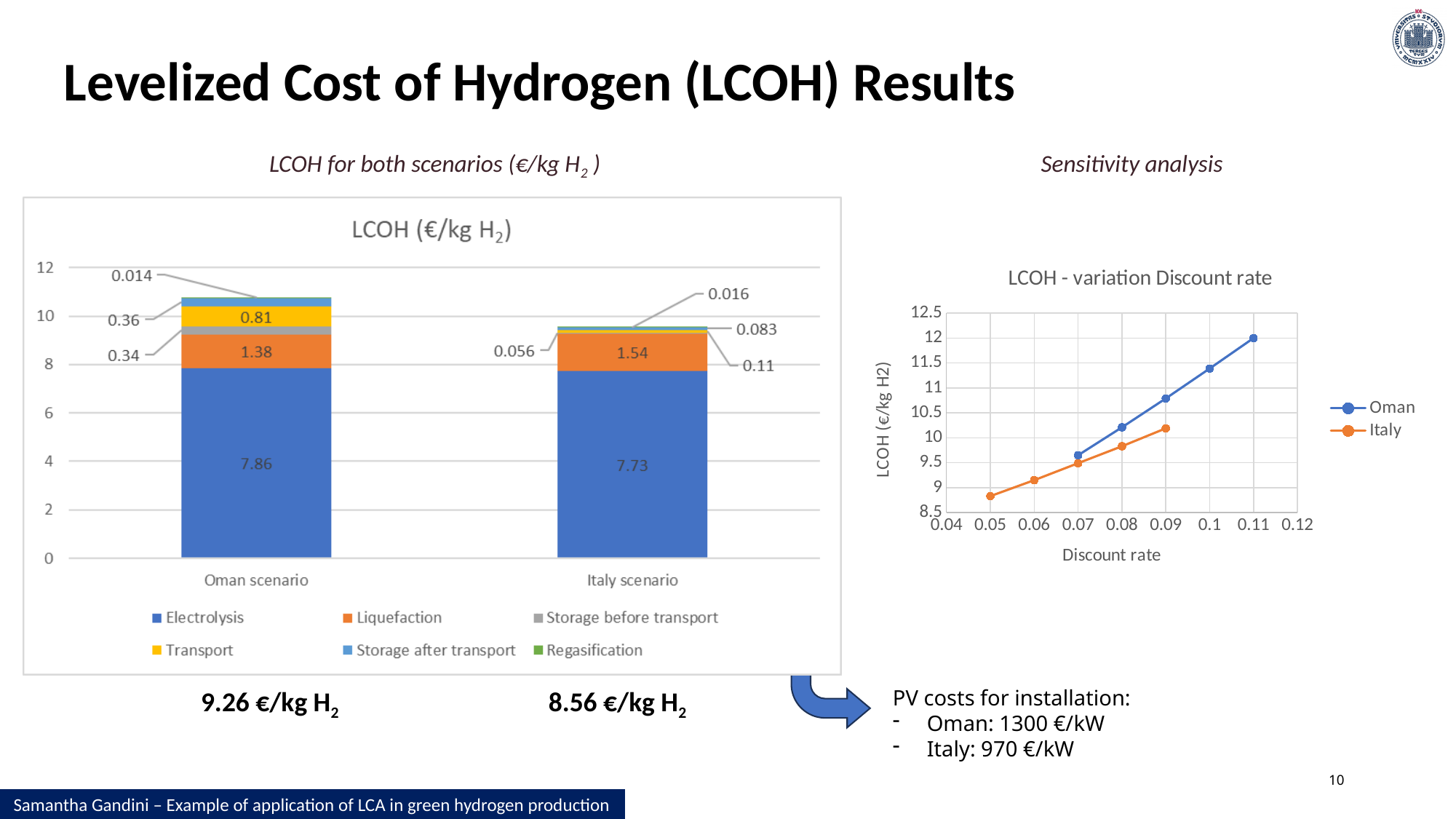
How many series does the legend of the LCOH (€/kg H2) stacked bar chart list? 6 In the LCOH - variation Discount rate chart, how many series does the legend list? 2 How many scenarios are shown on the x axis of the LCOH (€/kg H2) chart? 2 In the LCOH (€/kg H2) stacked bar chart, what is the difference between the Liquefaction values of the Italy and Oman scenarios? 0.16 In the LCOH (€/kg H2) stacked bar chart, what is the difference between the Electrolysis values of the Oman and Italy scenarios? 0.13 In the LCOH (€/kg H2) stacked bar chart, what is the Liquefaction value for the Italy scenario? 1.54 In the LCOH - variation Discount rate chart, is the Oman value at a discount rate of 0.1 greater or less than 11? greater In the LCOH (€/kg H2) stacked bar chart, what is the Electrolysis value for the Oman scenario? 7.86 In the LCOH (€/kg H2) stacked bar chart, what is the Transport value for the Oman scenario? 0.81 In the LCOH - variation Discount rate chart, does the LCOH for Oman rise or fall as the discount rate increases? Rise What kind of chart is the LCOH - variation Discount rate chart? Line chart In the LCOH (€/kg H2) stacked bar chart, which scenario has the larger Electrolysis value? Oman scenario